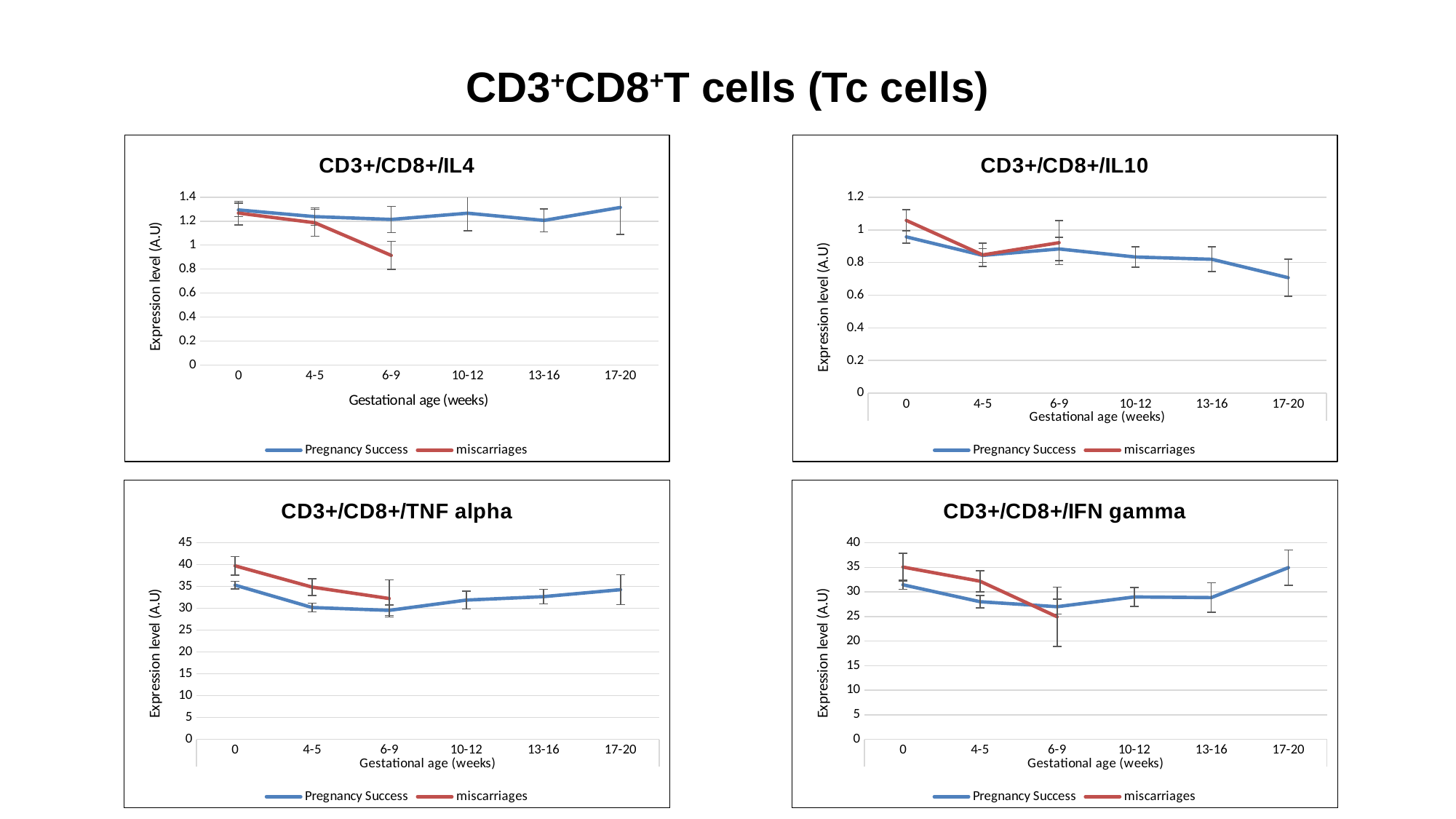
In the CD3+/CD8+/TNF alpha chart, which series has the larger value at gestational age 0, Pregnancy Success or miscarriages? miscarriages In the CD3+/CD8+/IFN gamma chart, at which gestational age is the Pregnancy Success value highest? 17-20 In the CD3+/CD8+/IFN gamma chart, is the miscarriages value at 6-9 weeks greater or less than 30? less In the CD3+/CD8+/IFN gamma chart, how many data points does the miscarriages series have? 3 What kind of chart is the CD3+/CD8+/IL4 chart? line chart How many gestational age categories are shown on the x axis of the CD3+/CD8+/IL10 chart? 6 In the CD3+/CD8+/IL4 chart, which series has the larger value at 6-9 weeks, Pregnancy Success or miscarriages? Pregnancy Success What is the x-axis title of the CD3+/CD8+/TNF alpha chart? Gestational age (weeks) In the CD3+/CD8+/IL10 chart, does the Pregnancy Success line rise or fall from gestational age 0 to 17-20 weeks? fall In the CD3+/CD8+/IL10 chart, is the Pregnancy Success value at 17-20 weeks greater or less than 0.8? less How many series does the legend of the CD3+/CD8+/TNF alpha chart list? 2 In the CD3+/CD8+/TNF alpha chart, is the miscarriages value at gestational age 0 greater or less than 35? greater